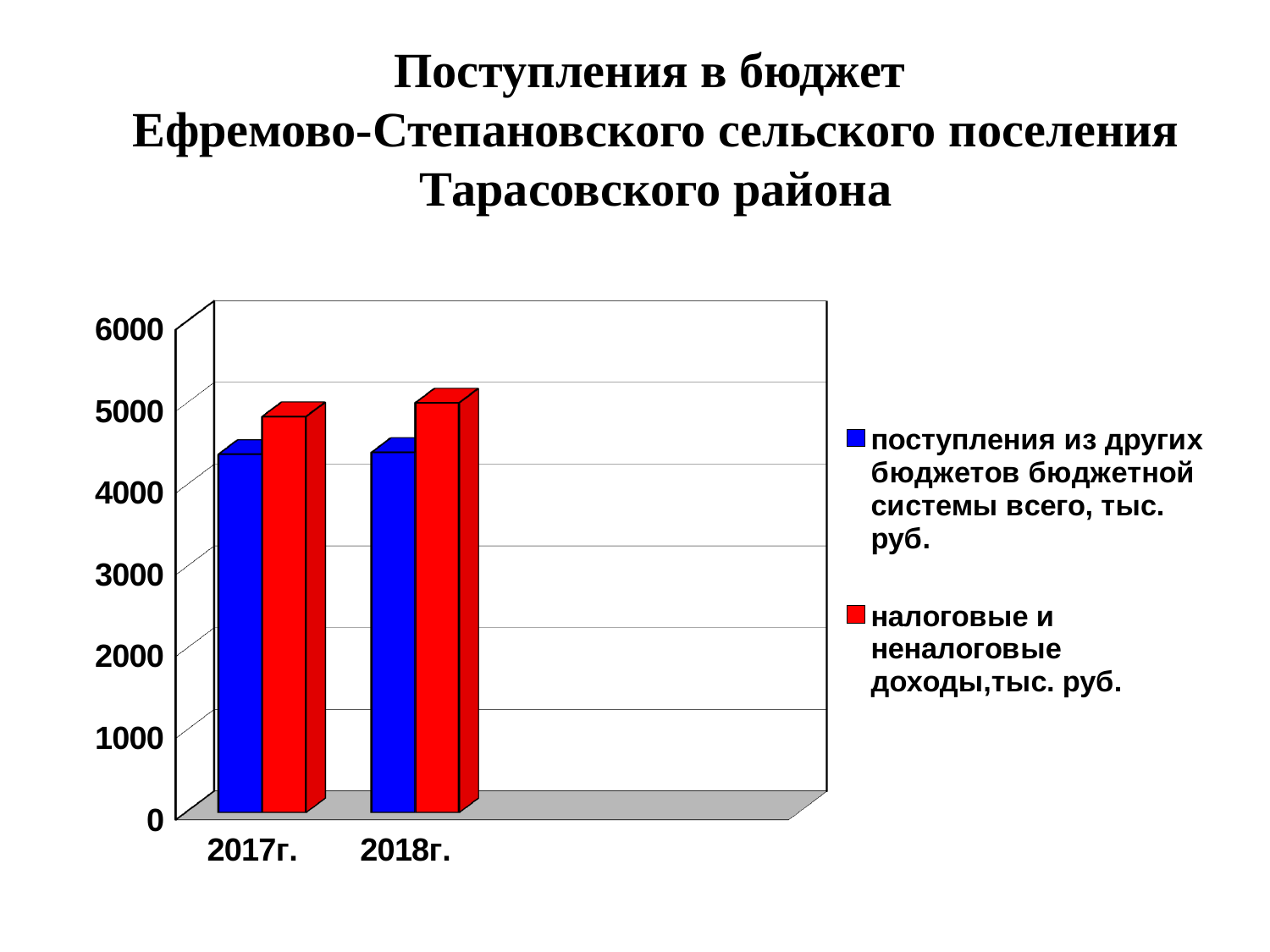
Which years are shown on the x axis? 2017г. and 2018г. In 2018г., which series has the larger value: 'поступления из других бюджетов' or 'налоговые и неналоговые доходы'? налоговые и неналоговые доходы Is the value for 'поступления из других бюджетов бюджетной системы всего, тыс. руб.' in 2018г. greater or less than 5000? less How many categories (years) are shown on the x axis? 2 Which colour represents the series 'налоговые и неналоговые доходы, тыс. руб.'? red Is the value for 'налоговые и неналоговые доходы, тыс. руб.' in 2017г. greater or less than 4000? greater In 2017г., which series has the larger value: 'поступления из других бюджетов' or 'налоговые и неналоговые доходы'? налоговые и неналоговые доходы Is the value for 'налоговые и неналоговые доходы, тыс. руб.' in 2018г. greater or less than 6000? less What kind of chart is shown on the slide? bar chart Does the value for 'налоговые и неналоговые доходы, тыс. руб.' rise or fall from 2017г. to 2018г.? rise How many series does the legend list? 2